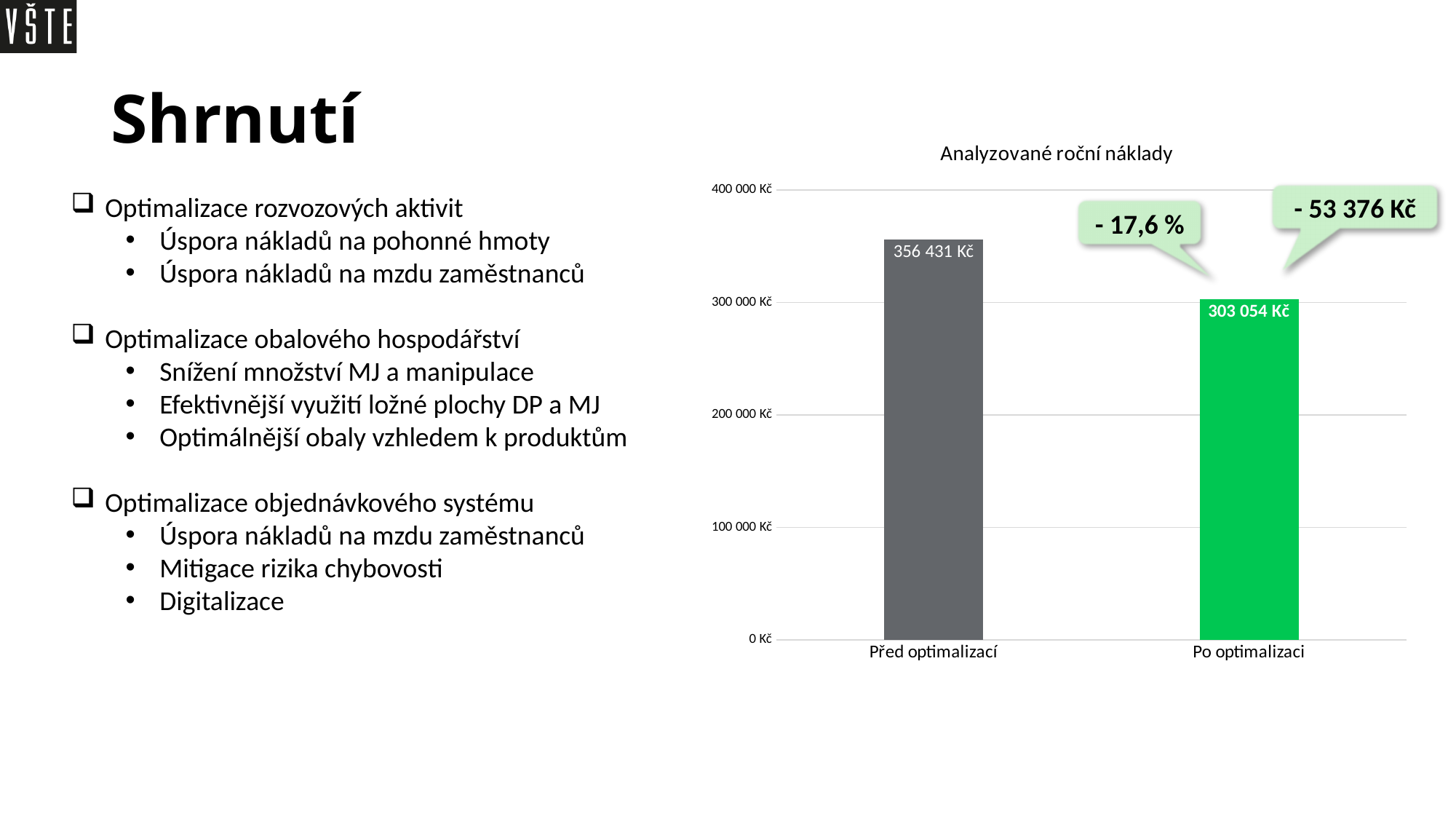
Which category has the highest value? Před optimalizací What is the title of the chart? Analyzované roční náklady Which is larger, the value for Před optimalizací or Po optimalizaci? Před optimalizací What is the value for Po optimalizaci? 303 054 Kč What kind of chart is shown on the slide? bar chart What is the value for Před optimalizací? 356 431 Kč Do the values rise or fall from Před optimalizací to Po optimalizaci? fall Is the value for Před optimalizací greater or less than 300 000 Kč? greater Is the value for Po optimalizaci greater or less than 400 000 Kč? less Which category has the lowest value? Po optimalizaci How many categories are shown on the x axis? 2 What is the difference between the values for Před optimalizací and Po optimalizaci? 53 377 Kč